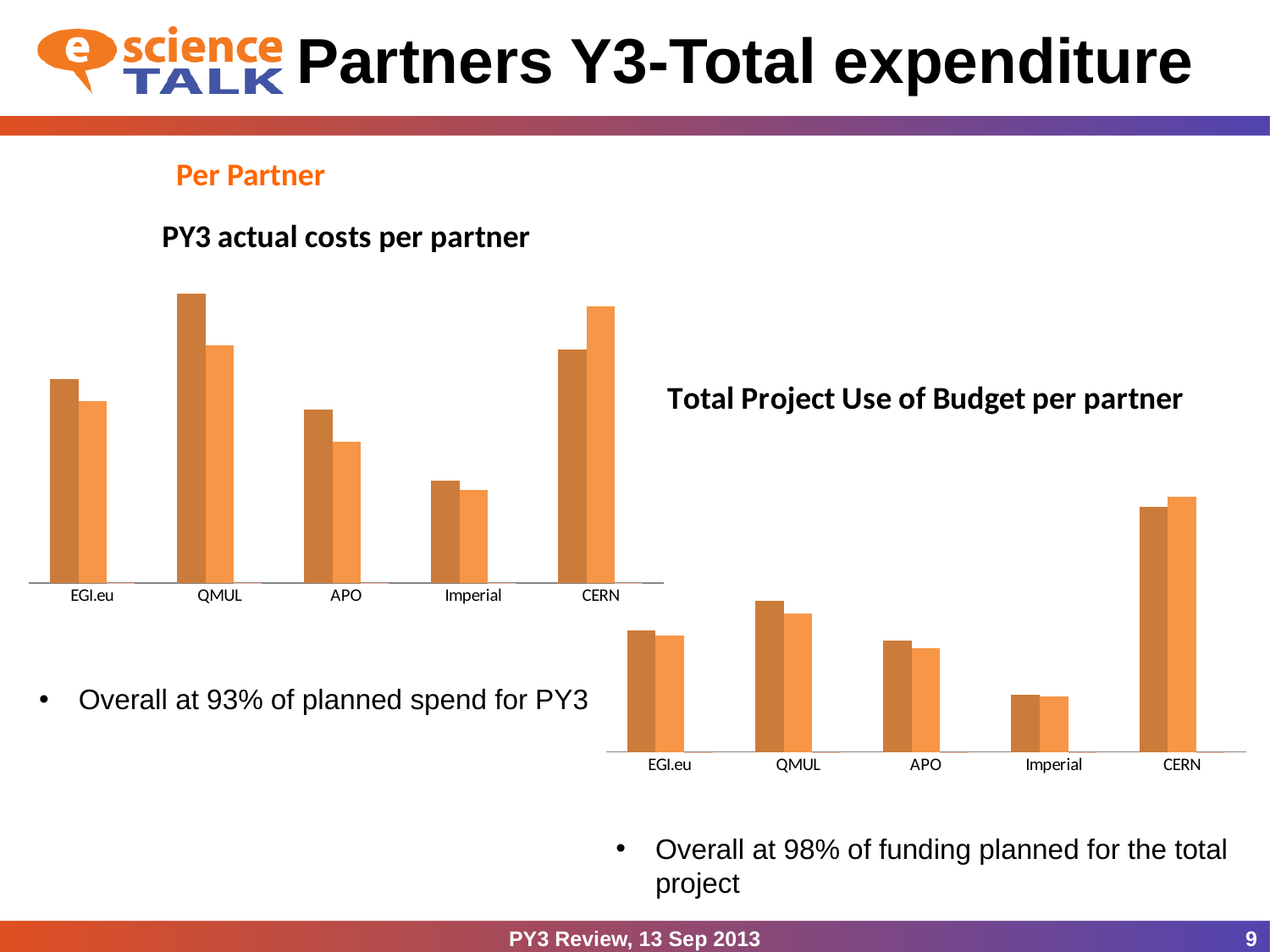
In the 'Total Project Use of Budget per partner' chart, which partner has taller bars, QMUL or APO? QMUL What kind of chart is the 'PY3 actual costs per partner' chart? bar chart How many partners are shown on the x axis of the 'Total Project Use of Budget per partner' chart? 5 What kind of chart is the 'Total Project Use of Budget per partner' chart? bar chart What is the title of the chart on the right side of the slide? Total Project Use of Budget per partner In the 'Total Project Use of Budget per partner' chart, which partner has the shortest bars? Imperial In the 'PY3 actual costs per partner' chart, which partner has taller bars, EGI.eu or Imperial? EGI.eu In the 'PY3 actual costs per partner' chart, which partner has taller bars, APO or CERN? CERN How many partners are shown on the x axis of the 'PY3 actual costs per partner' chart? 5 In the 'Total Project Use of Budget per partner' chart, which partner has the tallest bars? CERN In the 'PY3 actual costs per partner' chart, which partner has the shortest bars? Imperial In the 'PY3 actual costs per partner' chart, which partner has the tallest bar? QMUL